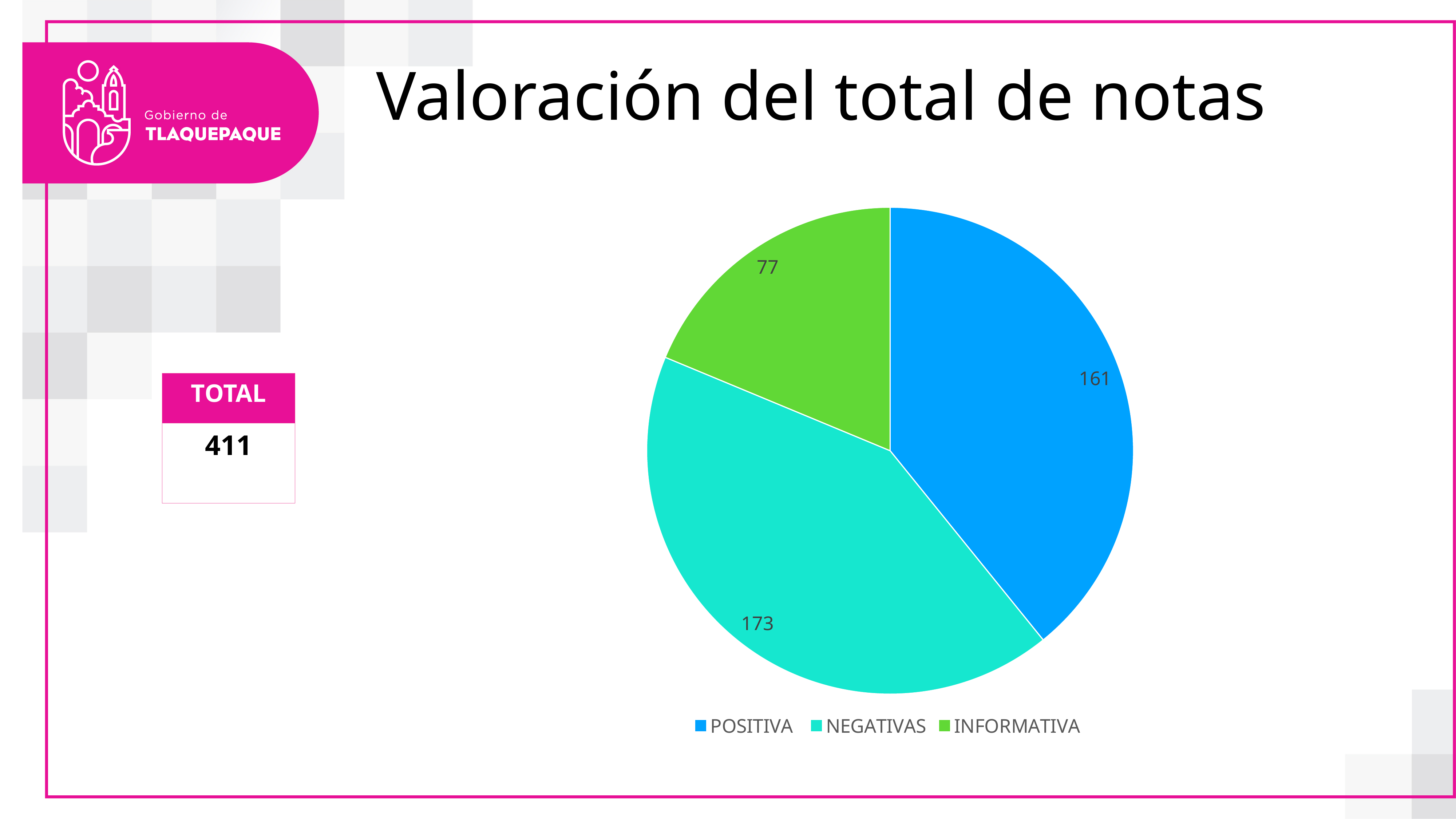
What kind of chart is shown on the slide? pie chart How many slices does the pie chart have? 3 What is the total of all three slices? 411 What colour is the NEGATIVAS slice? turquoise What is the value for INFORMATIVA? 77 Which category has the largest slice? NEGATIVAS What is the difference between POSITIVA and INFORMATIVA? 84 What is the value for POSITIVA? 161 Which category has the smallest slice? INFORMATIVA Which is larger, POSITIVA or INFORMATIVA? POSITIVA What is the difference between NEGATIVAS and POSITIVA? 12 What is the value for NEGATIVAS? 173